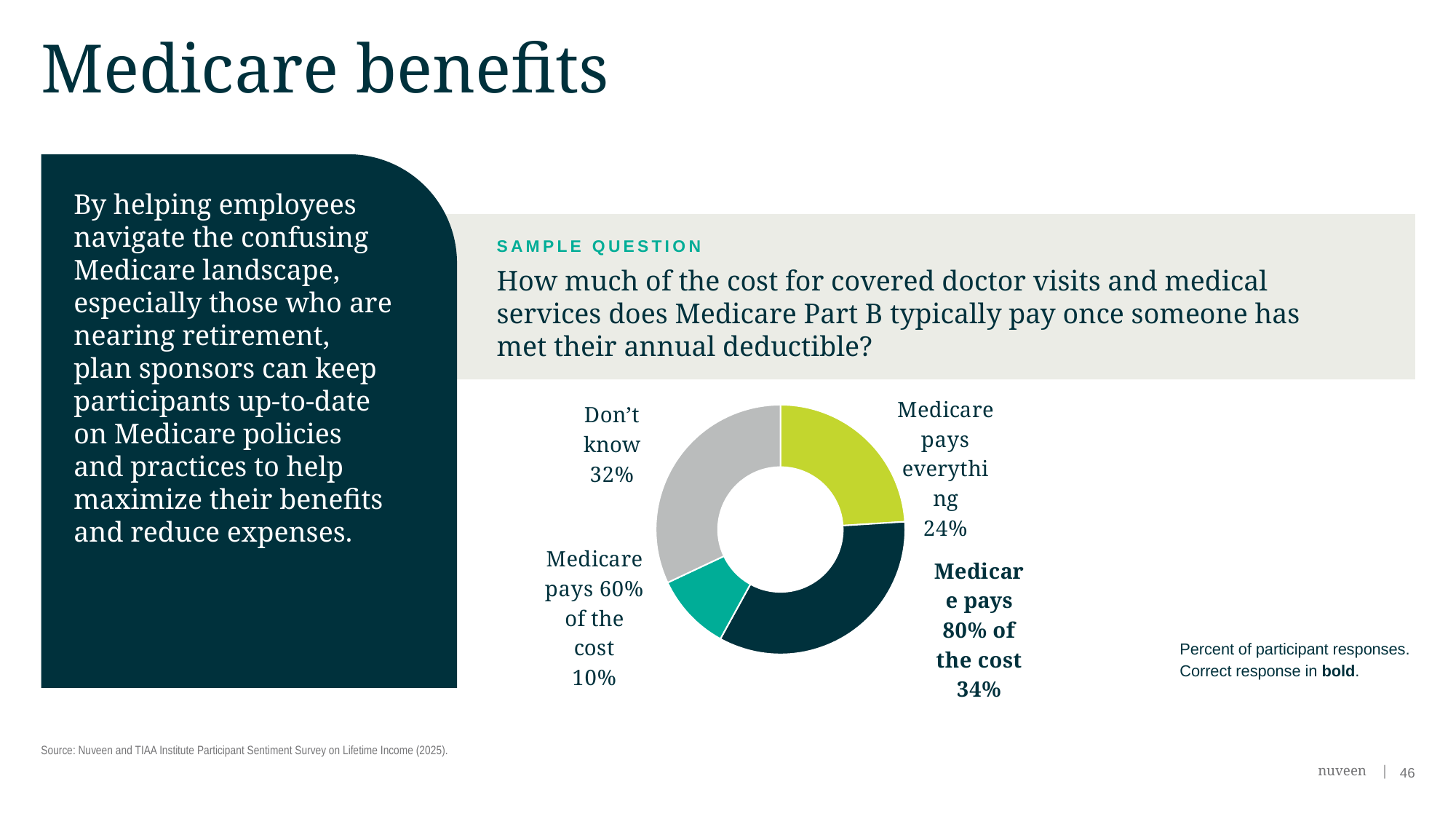
Which received more responses: "Don't know" or "Medicare pays everything"? Don't know What is the difference in percentage points between "Don't know" and "Medicare pays everything"? 8 Which response option received the largest share of participant responses? Medicare pays 80% of the cost What percentage of participants answered "Medicare pays 80% of the cost"? 34% Which response option is shown in bold as the correct response? Medicare pays 80% of the cost What colour is the slice for "Don't know"? Grey How many response categories are shown in the chart? 4 What kind of chart is shown on the slide? Doughnut chart What percentage of participants answered "Medicare pays 60% of the cost"? 10% What percentage of participants answered "Don't know"? 32% What percentage of participants answered "Medicare pays everything"? 24% Which response option received the smallest share of participant responses? Medicare pays 60% of the cost